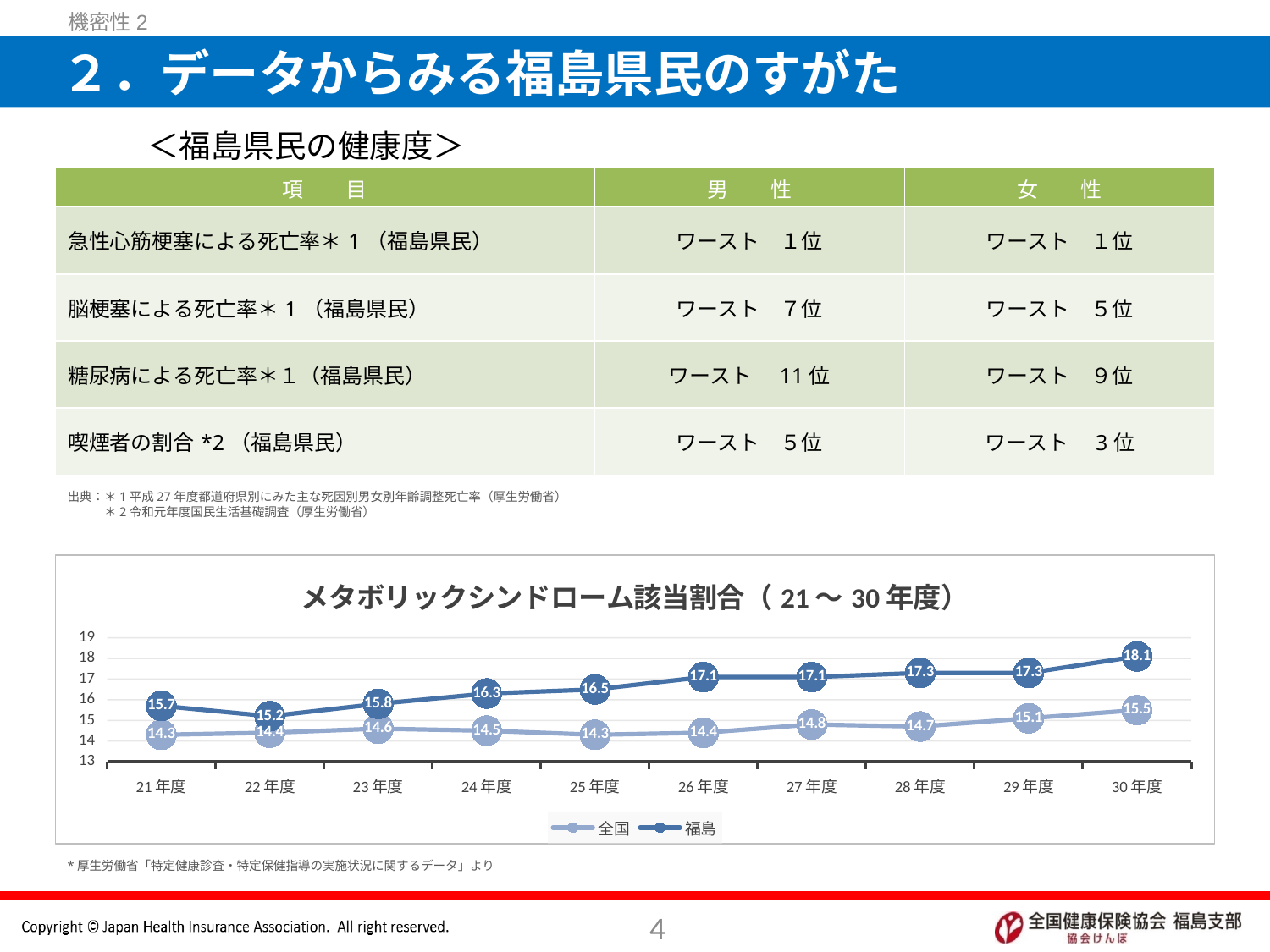
What is the value for 全国 in 21年度? 14.3 What is the value for 福島 in 30年度? 18.1 In which year does the 福島 series reach its highest value? 30年度 What type of chart is shown on the slide? line chart Which series has the higher value in 26年度, 全国 or 福島? 福島 What is the title of the chart? メタボリックシンドローム該当割合（21～30年度） How many series does the legend list? 2 Does the 福島 series generally rise or fall from 21年度 to 30年度? rise In which year does the 福島 series have its lowest value? 22年度 How many years (categories) are plotted on the x axis? 10 What is the value for 福島 in 24年度? 16.3 What is the difference between 福島 and 全国 in 30年度? 2.6